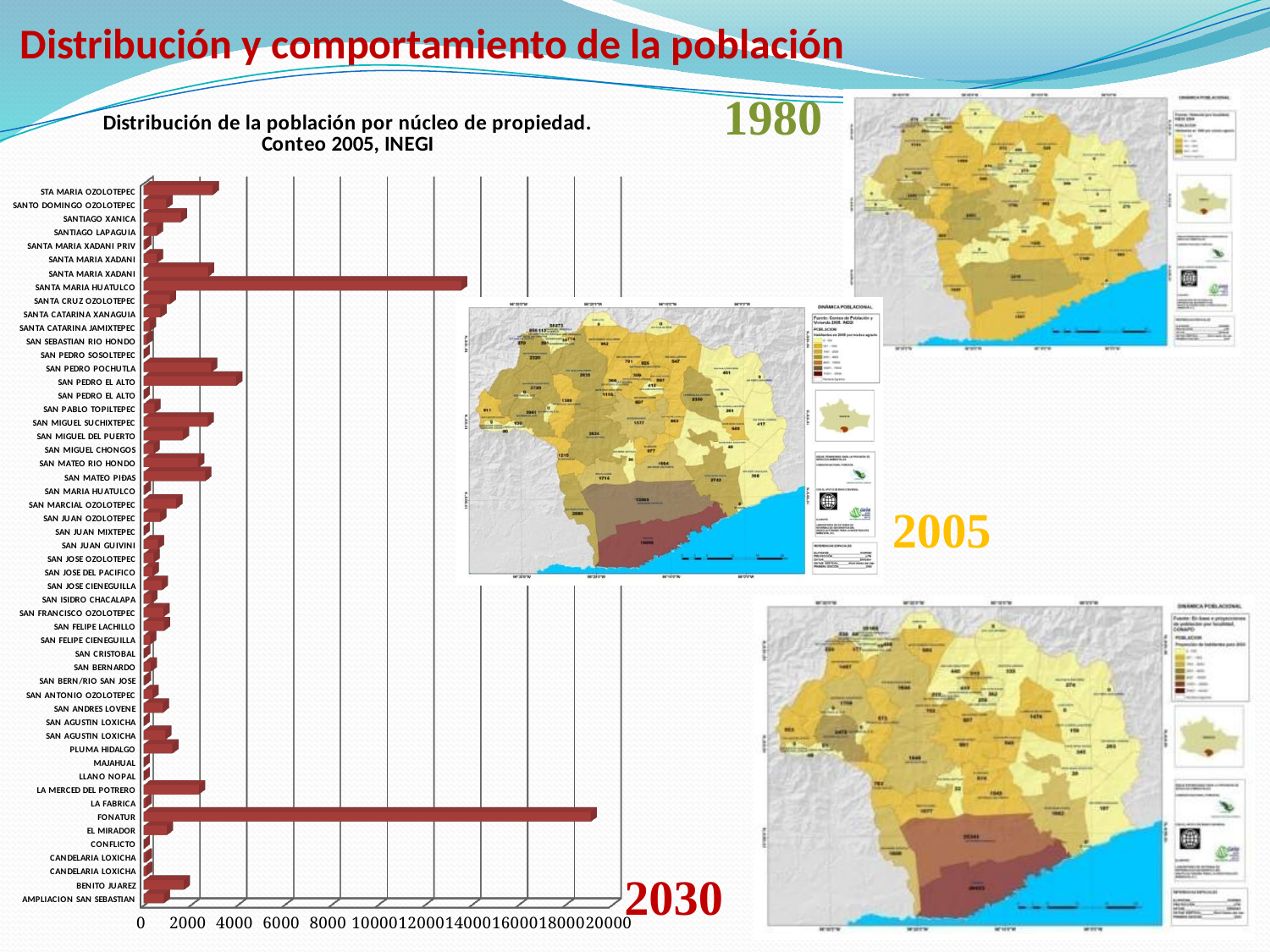
In the bar chart, which is larger, the value for SANTA MARIA HUATULCO or the value for SAN PEDRO EL ALTO? SANTA MARIA HUATULCO In the bar chart, is the value for SAN PEDRO POCHUTLA greater or less than 2000? greater In the bar chart, is the value for SAN PEDRO POCHUTLA greater or less than 6000? less What is the highest value shown on the horizontal axis of the bar chart? 20000 In the bar chart, is the value for SANTA MARIA HUATULCO greater or less than 12000? greater In the bar chart, which category has the highest population? FONATUR What kind of chart is 'Distribución de la población por núcleo de propiedad. Conteo 2005, INEGI'? bar chart In the bar chart, which is larger, the value for FONATUR or the value for SANTA MARIA HUATULCO? FONATUR According to the chart title, which source and year does the population data come from? Conteo 2005, INEGI